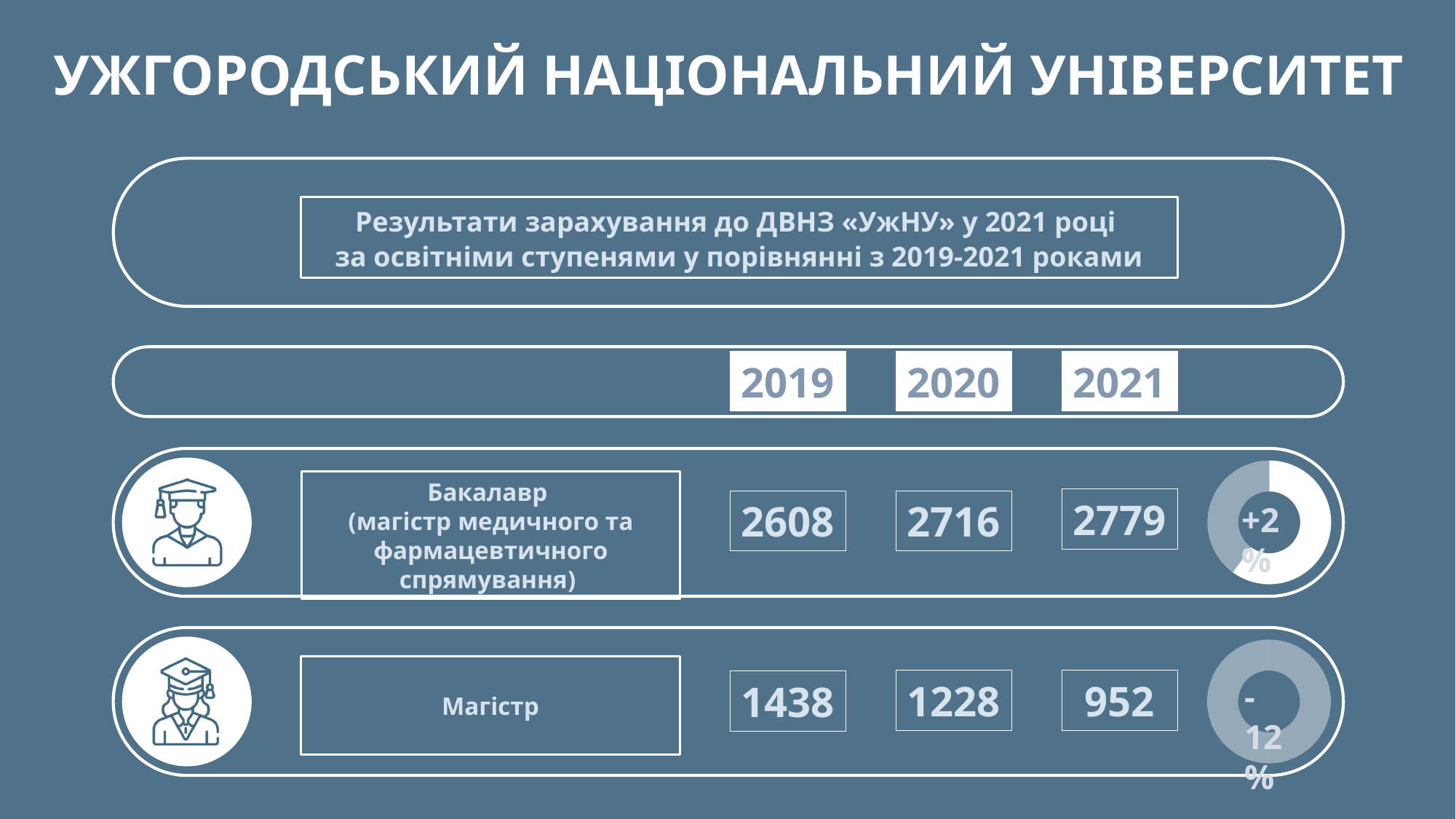
What is the difference between Bachelor enrolment in 2021 and 2020? 63 What was the number of enrolled Master students (Магістр) in 2019? 1438 What was the number of enrolled Bachelor students (Бакалавр) in 2019? 2608 In which year was the number of enrolled Master students (Магістр) lowest? 2021 How many years are compared on the slide? 3 In which year was the number of enrolled Bachelor students (Бакалавр) highest? 2021 What percentage change is shown in the donut chart for the Bachelor (Бакалавр) row? +2% What was the number of enrolled Bachelor students (Бакалавр) in 2021? 2779 Do the Master (Магістр) enrolment numbers rise or fall from 2019 to 2021? fall What is the difference between Master enrolment in 2019 and 2021? 486 What was the number of enrolled Master students (Магістр) in 2020? 1228 What percentage change is shown in the donut chart for the Master (Магістр) row? -12%